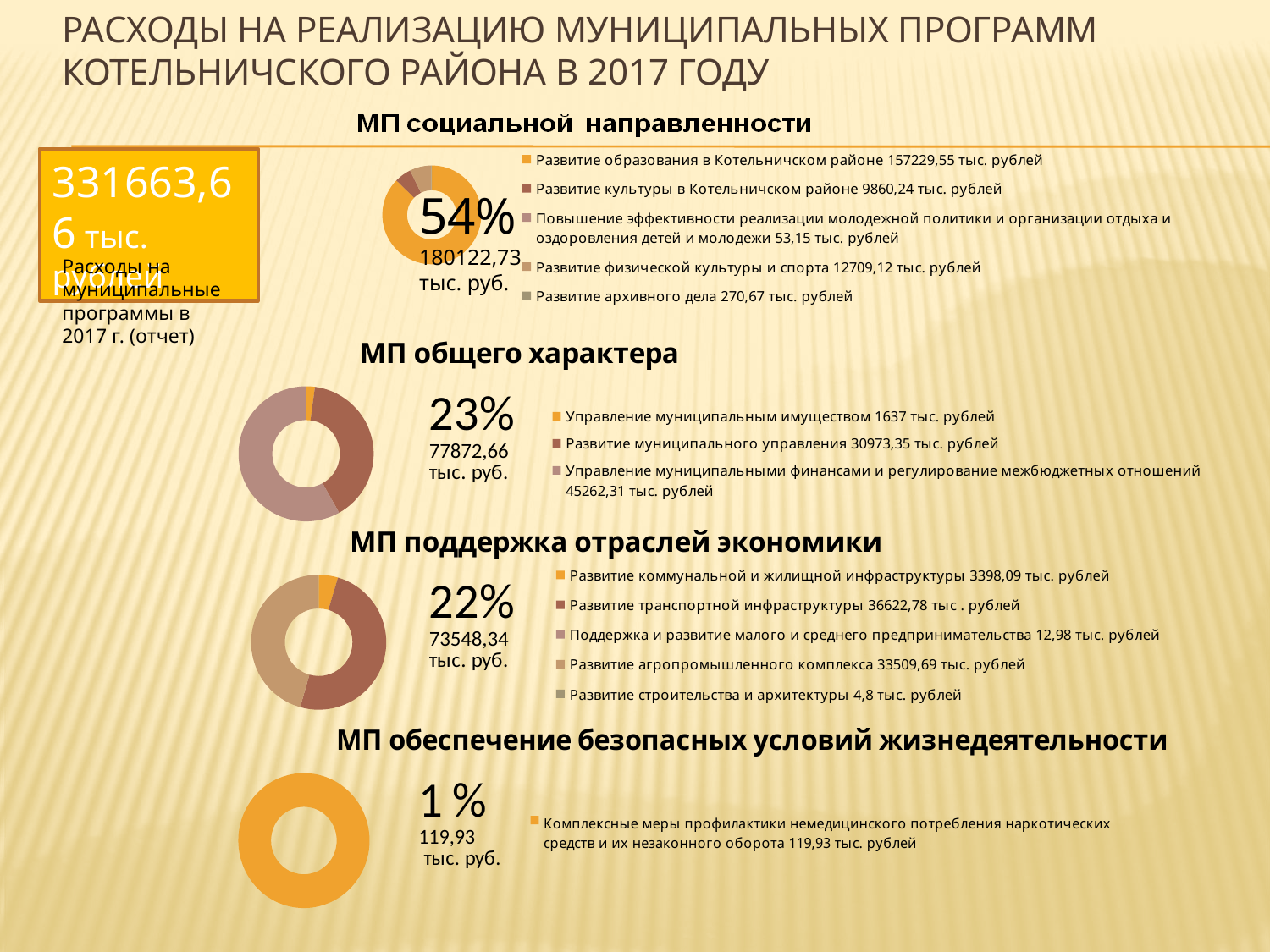
In the chart 'МП общего характера', which legend entry has the largest value? Управление муниципальными финансами и регулирование межбюджетных отношений What total amount is printed next to the chart 'МП социальной направленности'? 180122,73 тыс. руб. What percentage is printed next to the chart 'МП общего характера'? 23% In the chart 'МП общего характера', what is the difference between 'Управление муниципальными финансами и регулирование межбюджетных отношений' and 'Развитие муниципального управления'? 14288,96 тыс. рублей In the chart 'МП общего характера', what is the value for 'Развитие муниципального управления'? 30973,35 тыс. рублей In the chart 'МП социальной направленности', what is the value for 'Развитие образования в Котельничском районе'? 157229,55 тыс. рублей What kind of chart is used for 'МП обеспечение безопасных условий жизнедеятельности'? Doughnut (ring) chart How many legend entries does the chart 'МП поддержка отраслей экономики' list? 5 How many legend entries does the chart 'МП социальной направленности' list? 5 In the chart 'МП поддержка отраслей экономики', what is the value for 'Развитие строительства и архитектуры'? 4,8 тыс. рублей In the chart 'МП социальной направленности', which legend entry has the smallest value? Повышение эффективности реализации молодежной политики и организации отдыха и оздоровления детей и молодежи In the chart 'МП поддержка отраслей экономики', which is larger: 'Развитие транспортной инфраструктуры' or 'Развитие агропромышленного комплекса'? Развитие транспортной инфраструктуры